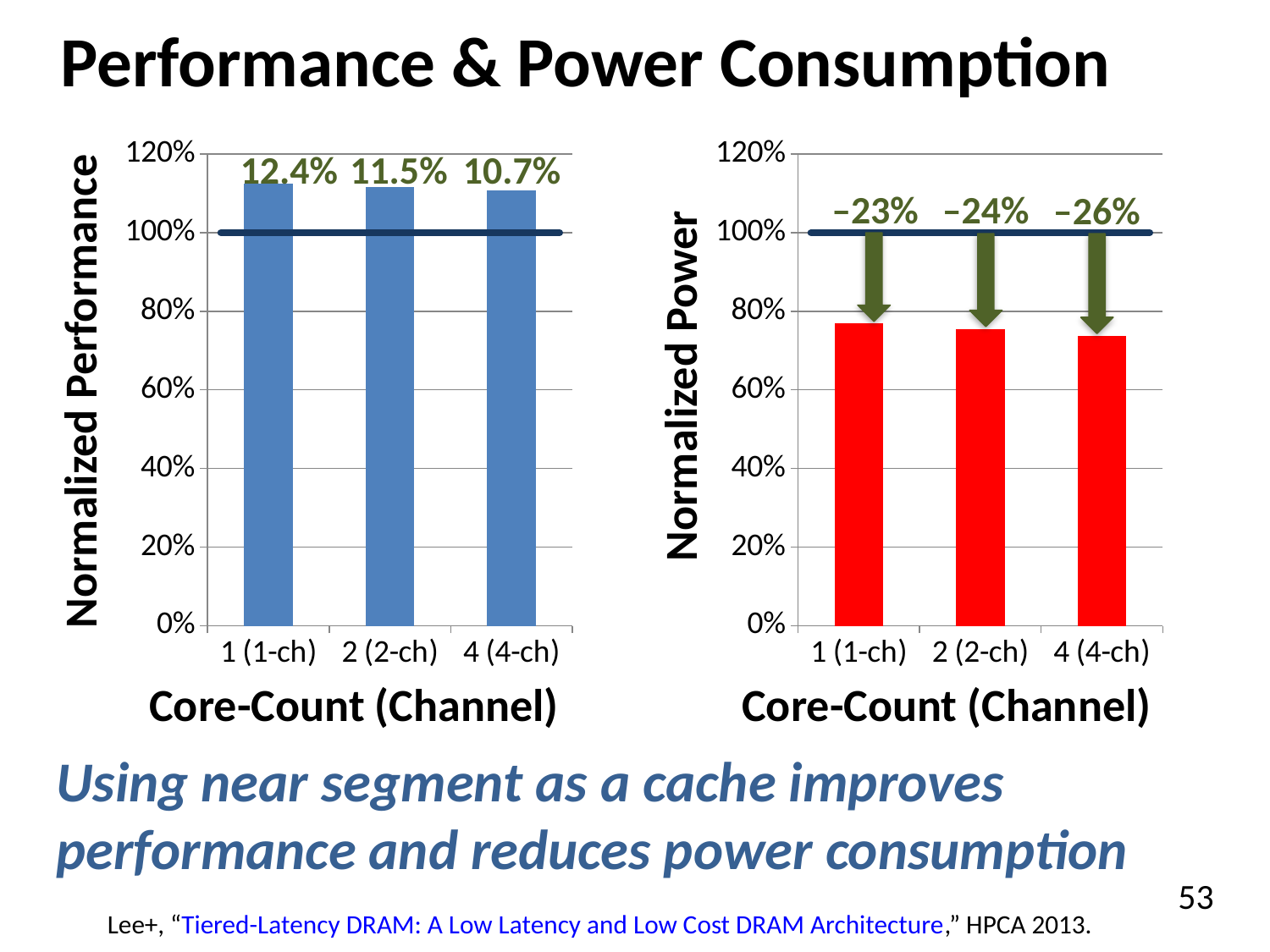
How many core-count categories are shown on the Normalized Power chart (right)? 3 On the Normalized Performance chart (left), what percentage label is printed above the bar for 4 (4-ch)? 10.7% On the Normalized Power chart (right), what percentage label is printed above the bar for 2 (2-ch)? –24% What is the x-axis title of the Normalized Performance chart (left)? Core-Count (Channel) On the Normalized Performance chart (left), what percentage label is printed above the bar for 1 (1-ch)? 12.4% On the Normalized Power chart (right), do the bar heights rise or fall from 1 (1-ch) to 4 (4-ch)? Fall What type of chart is the Normalized Performance chart on the left? Bar chart On the Normalized Performance chart (left), is the bar for 2 (2-ch) greater or less than 100%? greater On the Normalized Power chart (right), what percentage label is printed above the bar for 4 (4-ch)? –26% On the Normalized Power chart (right), is the bar for 1 (1-ch) greater or less than 80%? less On the Normalized Power chart (right), which core-count category has the shortest bar? 4 (4-ch) On the Normalized Performance chart (left), which core-count category has the tallest bar? 1 (1-ch)